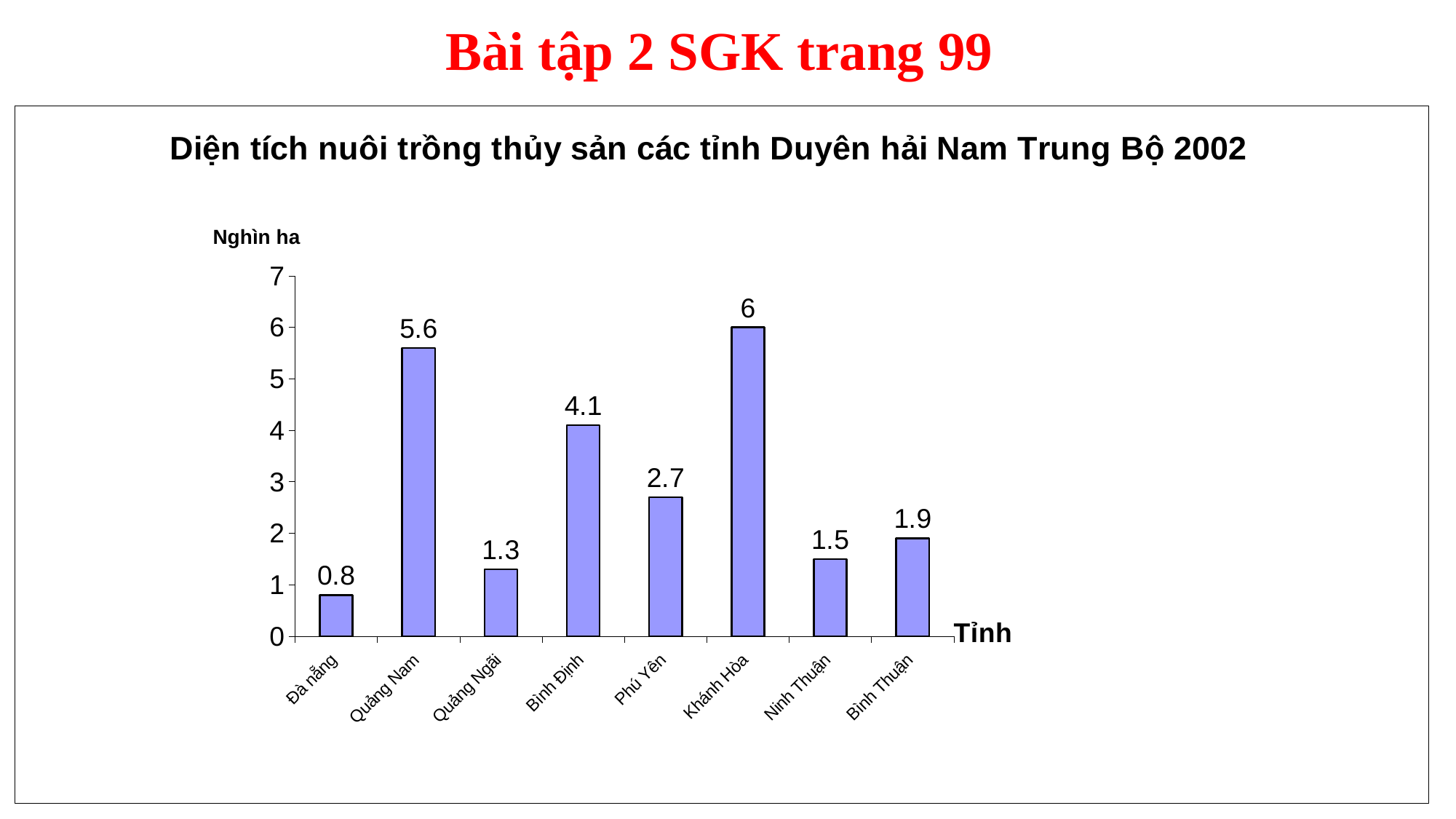
Which province has the lowest value? Đà Nẵng What kind of chart is this? bar chart What is the value for Đà Nẵng? 0.8 What is the value for Quảng Nam? 5.6 How many provinces are shown on the x axis? 8 Which province has the highest value? Khánh Hòa What is the value for Phú Yên? 2.7 What is the value for Khánh Hòa? 6 Which is larger, the value for Bình Thuận or the value for Ninh Thuận? Bình Thuận Is the value for Bình Định greater or less than 4? greater What is the difference between the values for Bình Định and Quảng Ngãi? 2.8 What unit is shown on the y axis? Nghìn ha